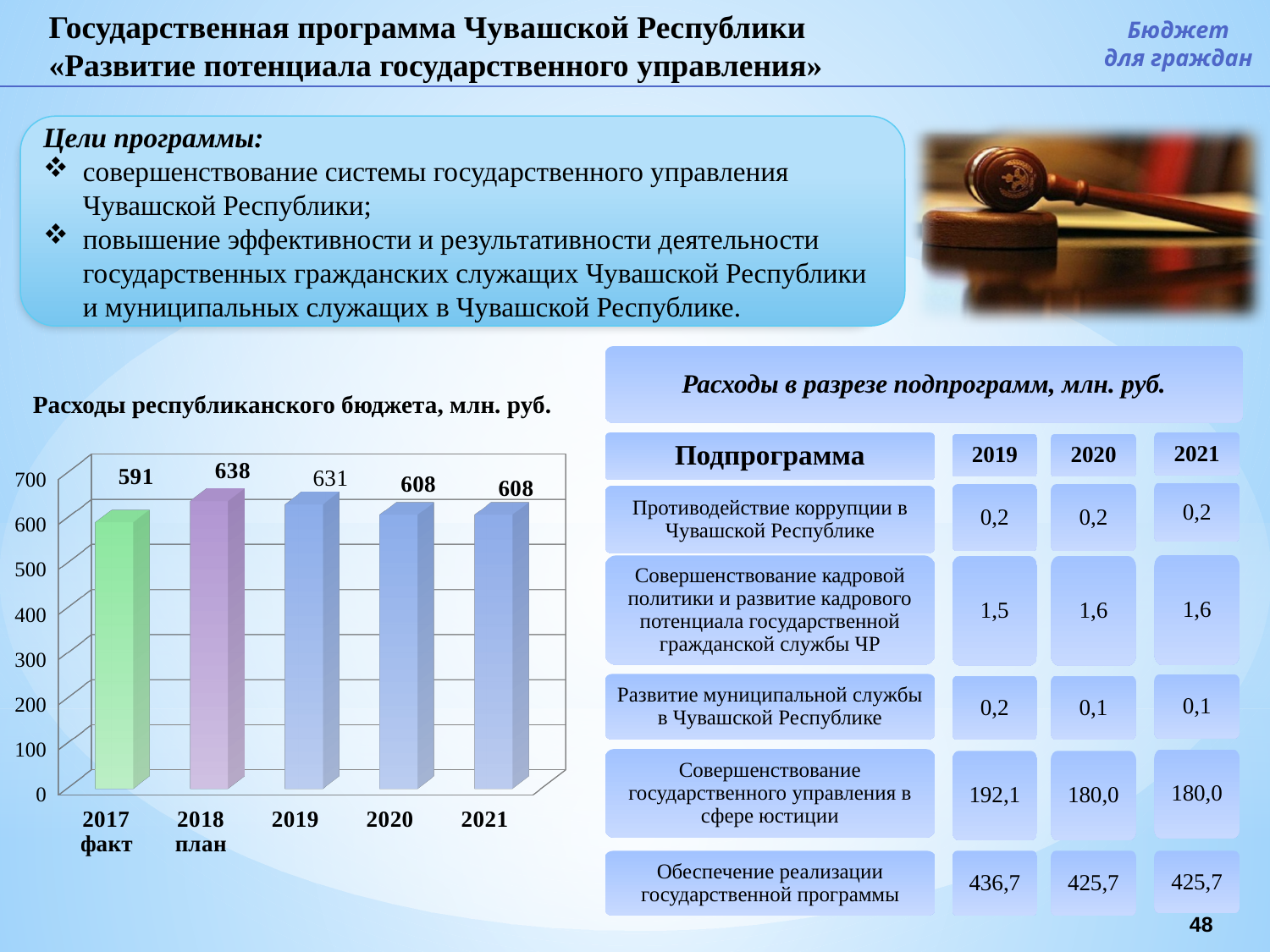
What is the value for 2019 in the chart 'Расходы республиканского бюджета, млн. руб.'? 631 Which year has the lowest value in the chart 'Расходы республиканского бюджета, млн. руб.'? 2017 факт What is the value for 2017 факт in the chart 'Расходы республиканского бюджета, млн. руб.'? 591 What is the difference between the values for 2019 and 2020 in the chart 'Расходы республиканского бюджета, млн. руб.'? 23 What type of chart is 'Расходы республиканского бюджета, млн. руб.'? bar chart Which year has the highest value in the chart 'Расходы республиканского бюджета, млн. руб.'? 2018 план In the chart 'Расходы республиканского бюджета, млн. руб.', which is larger: the value for 2019 or the value for 2021? 2019 How many bars are shown in the chart 'Расходы республиканского бюджета, млн. руб.'? 5 What is the value for 2018 план in the chart 'Расходы республиканского бюджета, млн. руб.'? 638 What is the difference between the values for 2018 план and 2017 факт in the chart 'Расходы республиканского бюджета, млн. руб.'? 47 In the chart 'Расходы республиканского бюджета, млн. руб.', do the values rise or fall from 2018 план to 2021? fall What is the value for 2021 in the chart 'Расходы республиканского бюджета, млн. руб.'? 608